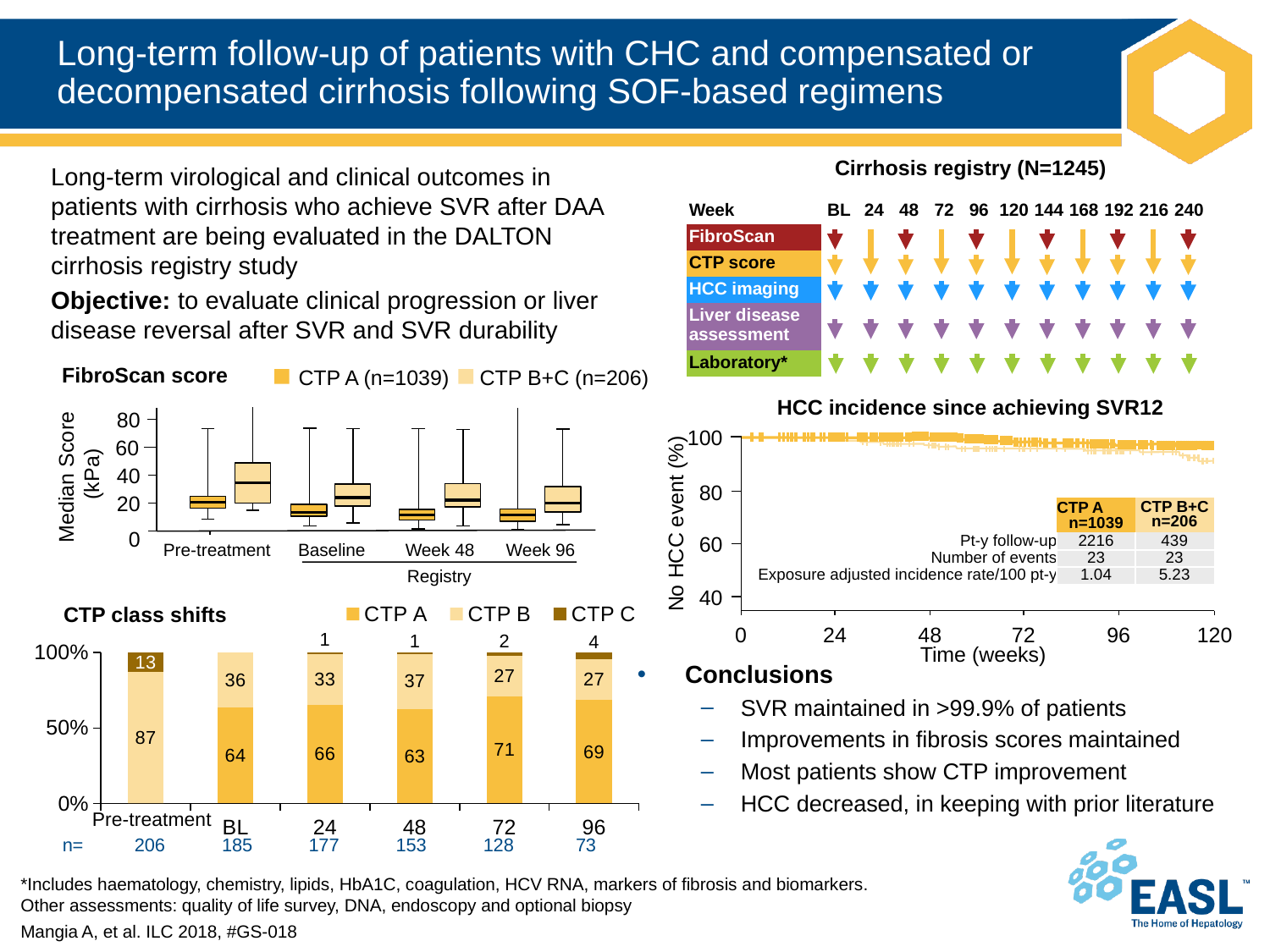
How many series does the legend of the CTP class shifts chart list? 3 In the CTP class shifts chart, what is the n value shown for week 96? 73 In the CTP class shifts chart, is the CTP B percentage larger at BL or at week 48? Week 48 In the CTP class shifts chart, what is the difference between the CTP A percentage at week 72 and at baseline (BL)? 7 In the HCC incidence since achieving SVR12 chart, what is the exposure adjusted incidence rate per 100 pt-y for CTP B+C? 5.23 What kind of chart is the FibroScan score chart? Box plot In the HCC incidence since achieving SVR12 chart, what is the patient-year follow-up for CTP A? 2216 In the CTP class shifts chart, what percentage of patients were CTP A at week 72? 71 In the CTP class shifts chart, what percentage of patients were CTP B at pre-treatment? 87 In the CTP class shifts chart, what percentage of patients were CTP C at week 96? 4 In the FibroScan score chart, is the pre-treatment median for CTP B+C greater or less than 20 kPa? greater In the CTP class shifts chart, at which time point is the CTP A percentage highest? 72